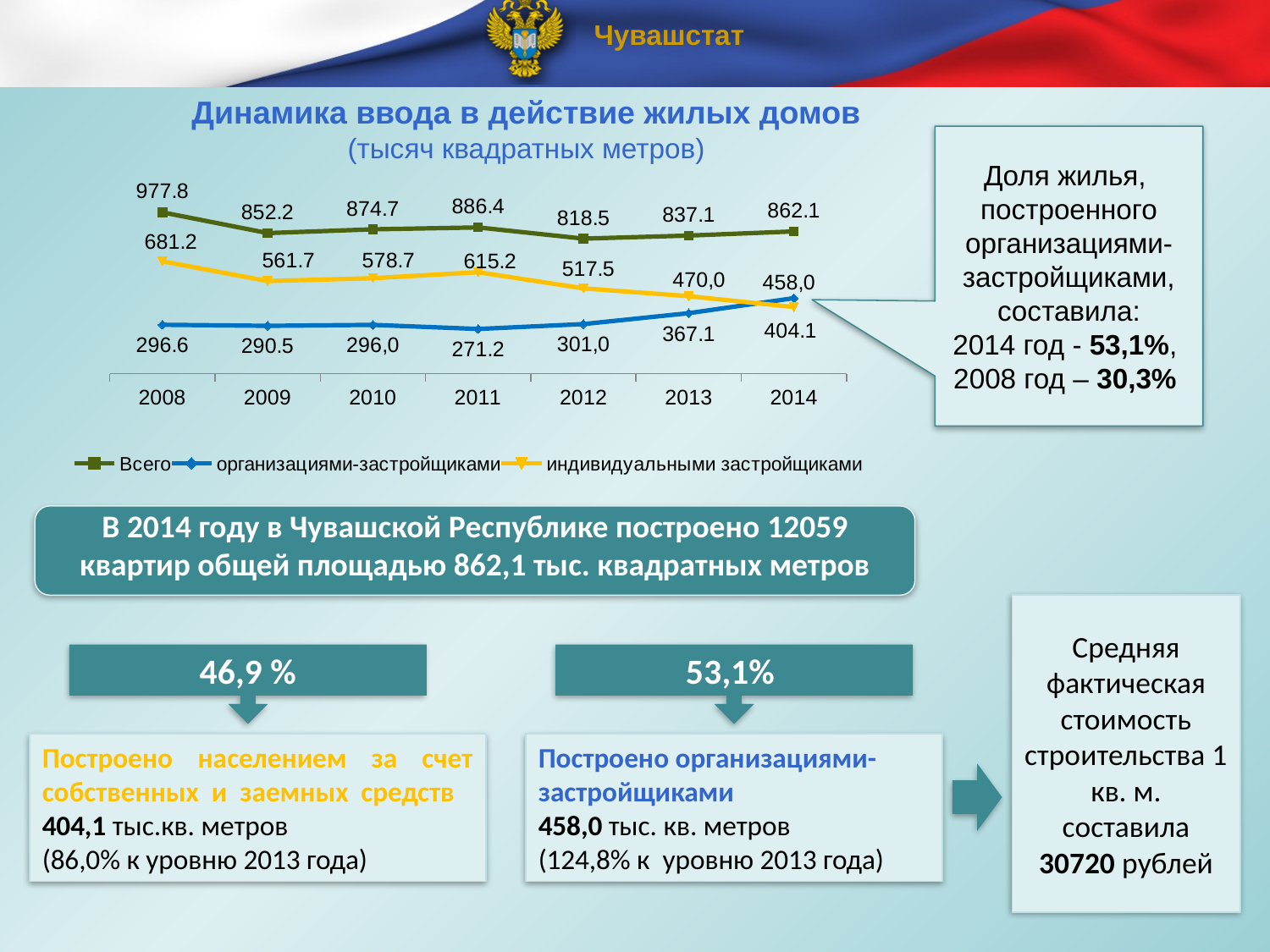
How many series does the chart legend list? 3 What is the value of the 'Всего' series in 2014? 862.1 What is the value of the 'Всего' series in 2008? 977.8 What is the value of the 'организациями-застройщиками' series in 2011? 271.2 How many years are shown on the x axis of the chart? 7 In which year is the 'Всего' series highest? 2008 Does the 'индивидуальными застройщиками' series rise or fall from 2011 to 2014? fall What is the difference between the 'Всего' values in 2008 and 2009? 125.6 What is the value of the 'индивидуальными застройщиками' series in 2012? 517.5 In which year is the 'организациями-застройщиками' series lowest? 2011 What type of chart is shown on the slide? line chart In 2014, which is larger: the 'организациями-застройщиками' value or the 'индивидуальными застройщиками' value? организациями-застройщиками